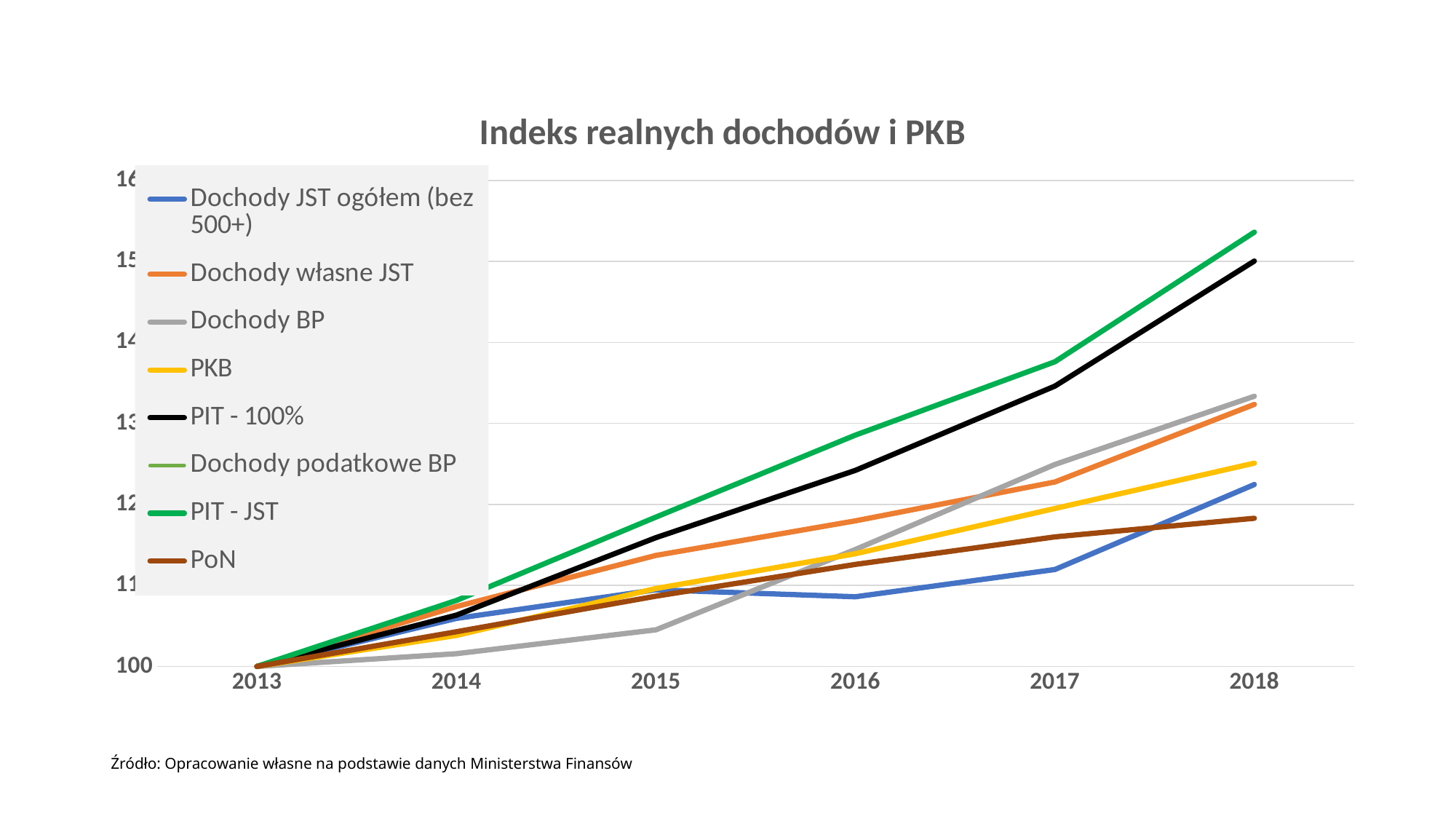
How many series does the legend list? 8 Which series has the lowest value in 2018? PoN In 2018, which is larger: Dochody BP or Dochody JST ogółem (bez 500+)? Dochody BP Is the value for PoN in 2018 greater or less than 120? less What kind of chart is shown on the slide? line chart Is the value for PIT - JST in 2018 greater or less than 150? greater How many years are shown on the x axis? 6 What is the value of PIT - JST in 2013? 100 Does the PIT - JST line rise or fall from 2013 to 2018? rise Which series has the highest value in 2018? PIT - JST In 2018, which is larger: PIT - JST or PIT - 100%? PIT - JST What is the title of the chart? Indeks realnych dochodów i PKB